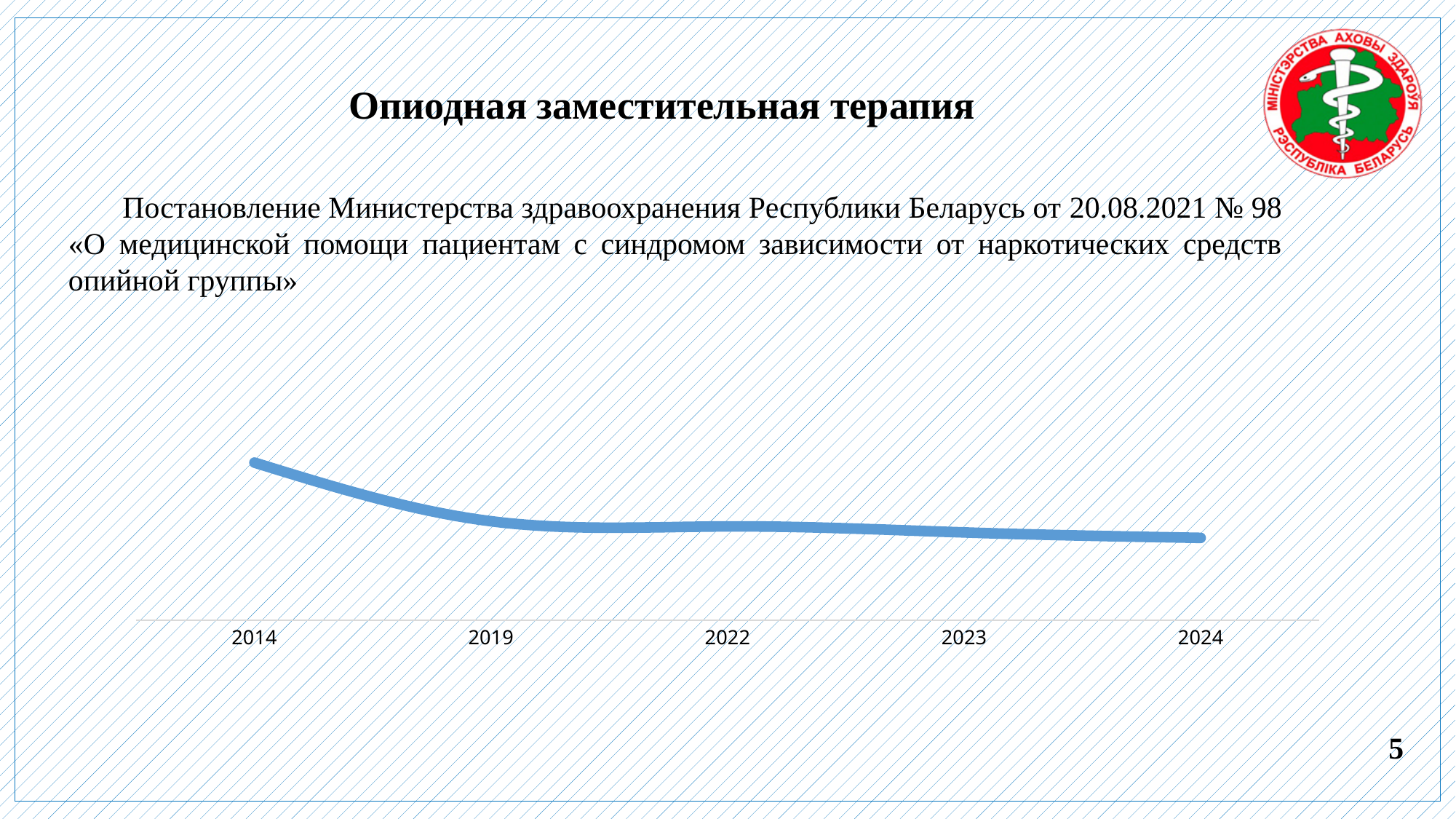
Which year has the lowest value on the chart? 2024 What is the first year labelled on the x axis of the chart? 2014 What kind of chart is shown on the slide? line chart Which is larger, the value for 2019 or the value for 2024? 2019 Which is larger, the value for 2014 or the value for 2019? 2014 Which year has the highest value on the chart? 2014 What is the last year labelled on the x axis of the chart? 2024 Does the plotted line rise or fall from 2014 to 2024? fall How many points (years) are labelled on the x axis of the chart? 5 Which is larger, the value for 2014 or the value for 2024? 2014